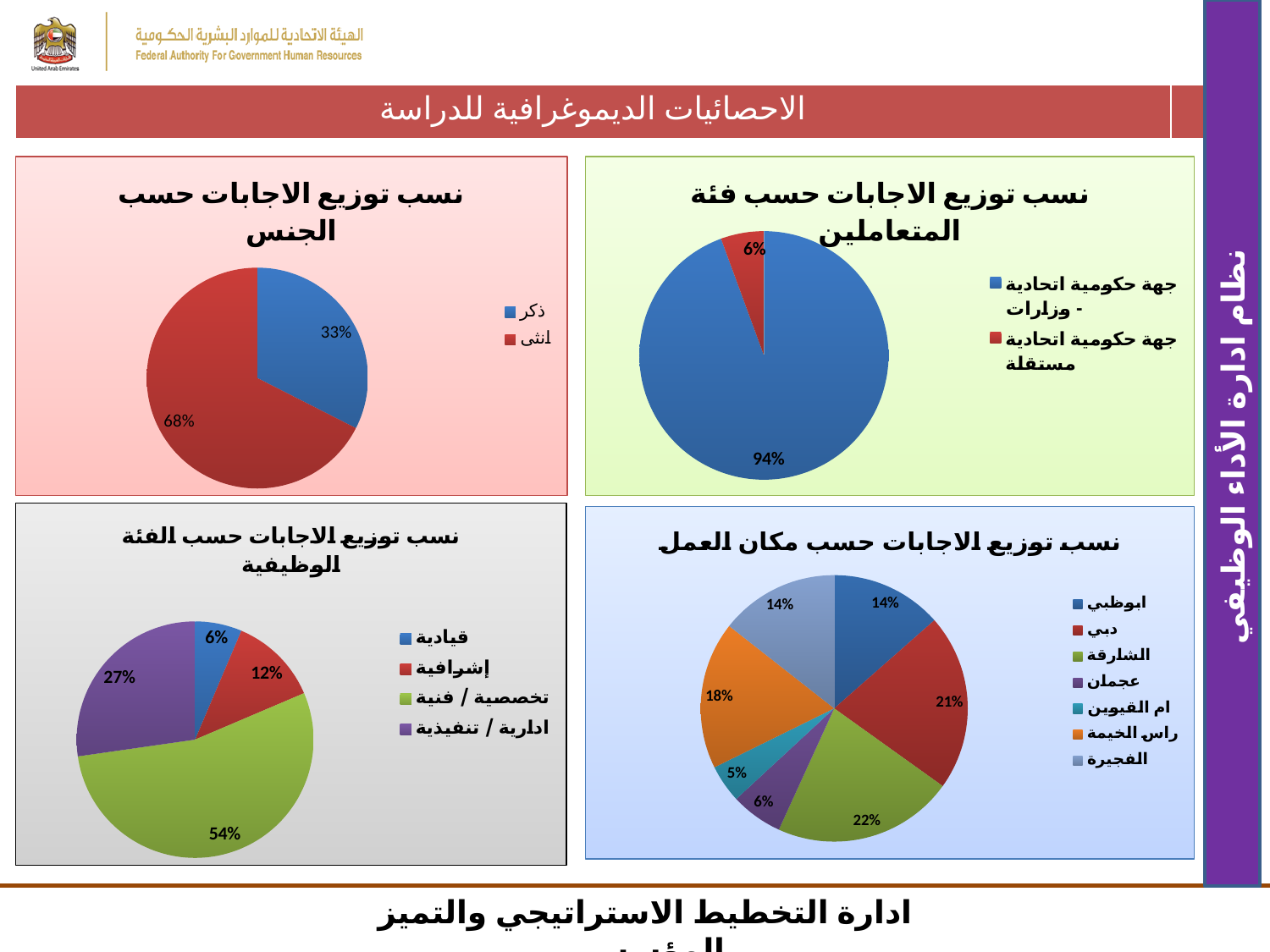
In the top-left pie chart (نسب توزيع الاجابات حسب الجنس), what percentage is shown for ذكر? 33% How many categories does the legend of the bottom-right pie chart (نسب توزيع الاجابات حسب مكان العمل) list? 7 In the bottom-right pie chart (نسب توزيع الاجابات حسب مكان العمل), which category has the smallest slice? ام القيوين In the bottom-right pie chart (نسب توزيع الاجابات حسب مكان العمل), which has the larger share, دبي or عجمان? دبي What type of chart is used in the top-left panel (نسب توزيع الاجابات حسب الجنس)? Pie chart In the bottom-right pie chart (نسب توزيع الاجابات حسب مكان العمل), what percentage is shown for راس الخيمة? 18% In the bottom-left pie chart (نسب توزيع الاجابات حسب الفئة الوظيفية), what percentage is shown for ادارية / تنفيذية? 27% In the top-right pie chart (نسب توزيع الاجابات حسب فئة المتعاملين), which category has the smallest slice? جهة حكومية اتحادية مستقلة In the top-left pie chart (نسب توزيع الاجابات حسب الجنس), what percentage is shown for أنثى? 68% In the top-right pie chart (نسب توزيع الاجابات حسب فئة المتعاملين), what share does جهة حكومية اتحادية - وزارات have? 94% In the bottom-left pie chart (نسب توزيع الاجابات حسب الفئة الوظيفية), which category has the largest slice? تخصصية / فنية In the bottom-left pie chart (نسب توزيع الاجابات حسب الفئة الوظيفية), what is the difference between the percentages for إشرافية and قيادية? 6%